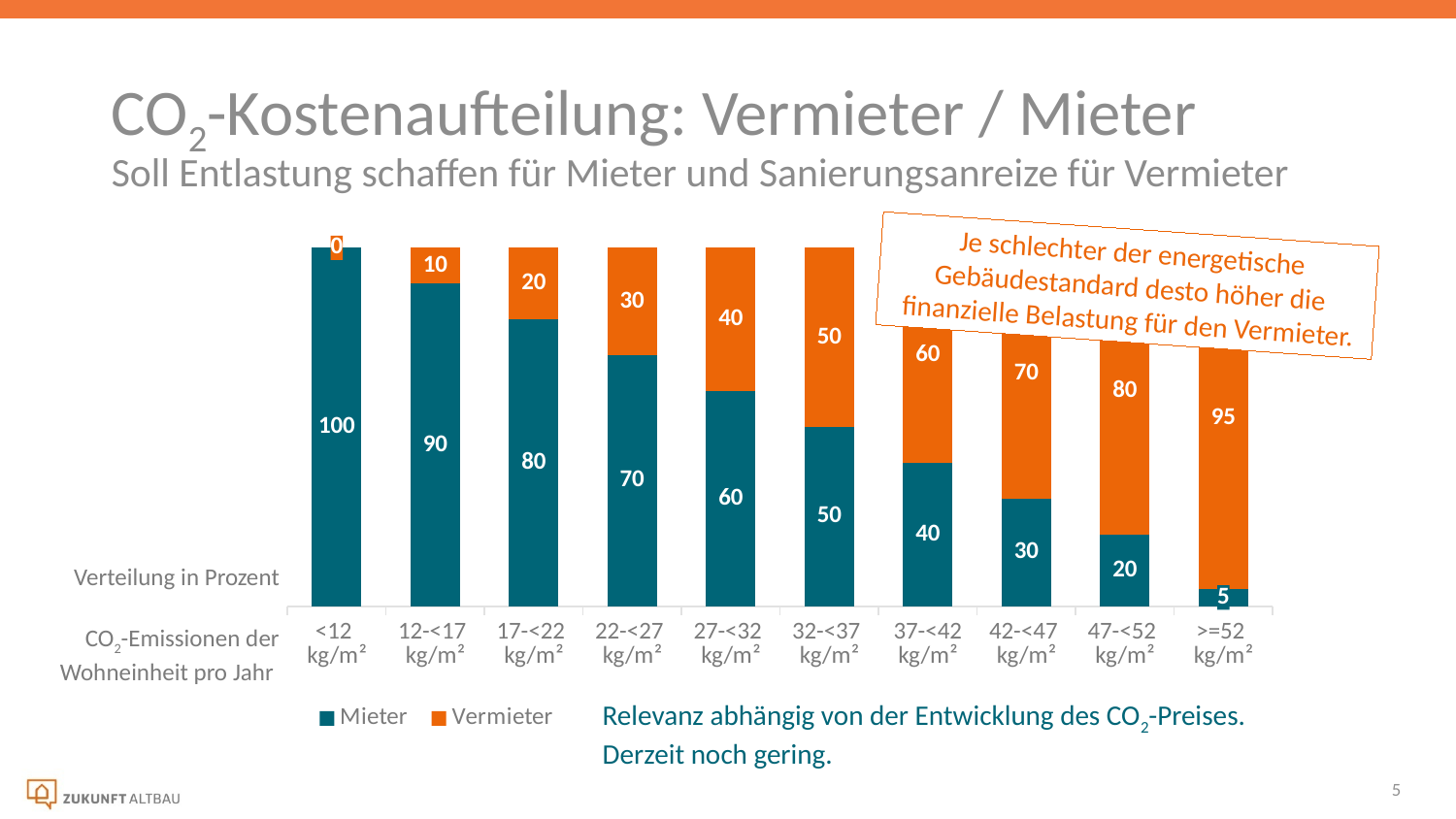
Which category has the lowest Vermieter value? <12 kg/m² What kind of chart is shown on the slide? Stacked bar chart What is the Vermieter value for the category 42-<47 kg/m²? 70 What is the Vermieter value for the category >=52 kg/m²? 95 How many series does the legend list? 2 What is the Mieter value for the category 22-<27 kg/m²? 70 How many categories are shown on the x axis? 10 What is the total of the stacked bar for the category 47-<52 kg/m²? 100 For the category 27-<32 kg/m², which is larger, the Mieter value or the Vermieter value? Mieter What is the difference between the Vermieter value and the Mieter value for the category 37-<42 kg/m²? 20 Which category has the highest Mieter value? <12 kg/m² Do the Mieter values rise or fall from left to right along the x axis? Fall